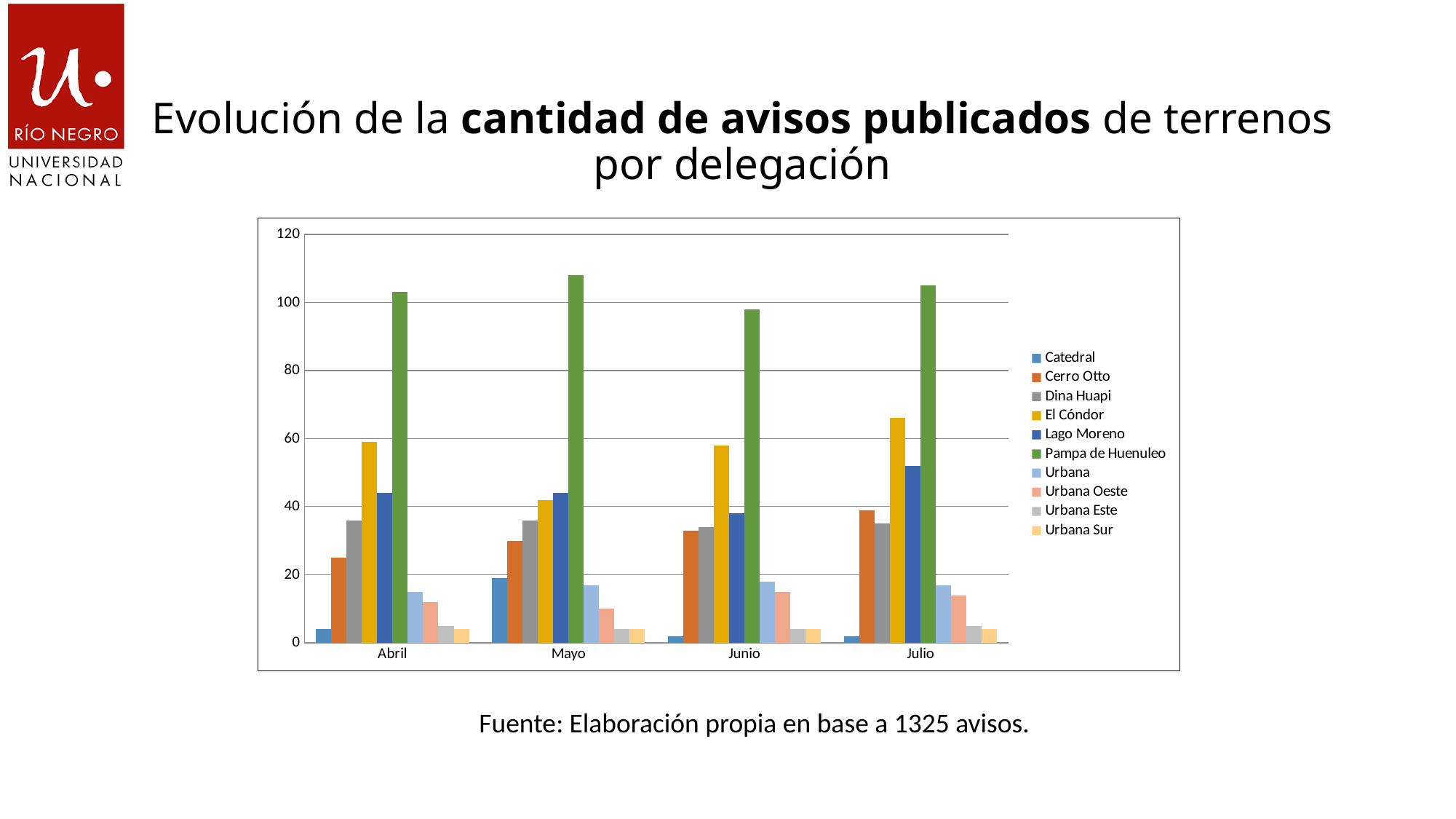
What colour represents Pampa de Huenuleo in the legend? Green Is the value for Pampa de Huenuleo in Mayo greater or less than 100? greater How many months are shown on the x axis? 4 In which month is the value for Pampa de Huenuleo lowest? Junio Is the value for El Cóndor in Julio greater or less than 60? greater Which is larger for Cerro Otto: the value in Abril or the value in Julio? Julio Is the value for El Cóndor in Mayo greater or less than 60? less How many series does the legend list? 10 Which delegación has the highest value in Abril? Pampa de Huenuleo What kind of chart is shown on the slide? Bar chart Do the values for Cerro Otto rise or fall from Abril to Julio? rise